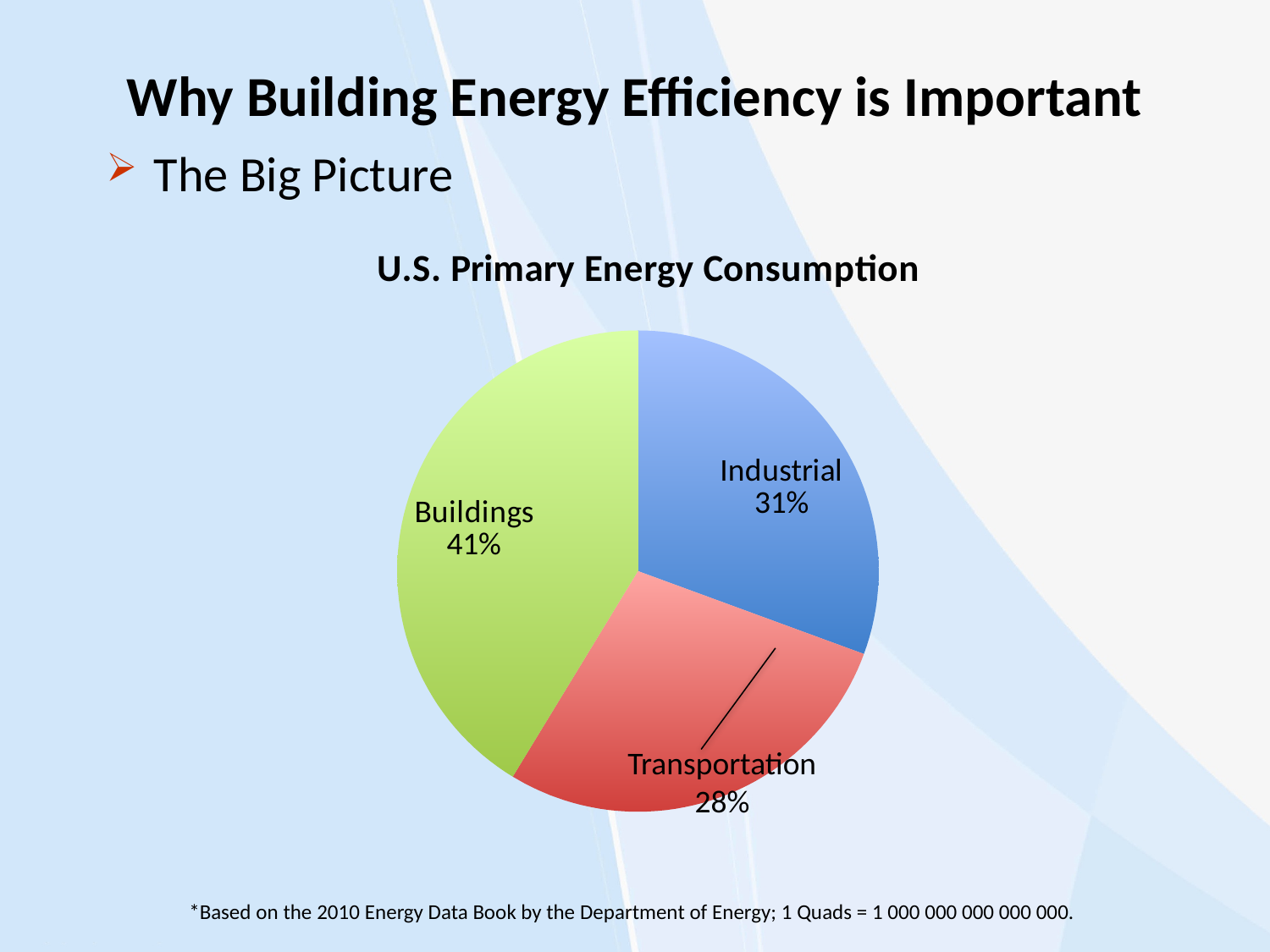
How many sectors are shown in the pie chart? 3 What is the title of the chart? U.S. Primary Energy Consumption What share of U.S. primary energy consumption is attributed to Transportation? 28% How many percentage points larger is the Industrial share than the Transportation share? 3% How many percentage points larger is the Buildings share than the Industrial share? 10% Which has a larger share of U.S. primary energy consumption, Buildings or Transportation? Buildings What kind of chart is shown on the slide? Pie chart What share of U.S. primary energy consumption is attributed to Buildings? 41% Which sector has the smallest share of U.S. primary energy consumption? Transportation What share of U.S. primary energy consumption is attributed to Industrial? 31% Which sector has the largest share of U.S. primary energy consumption? Buildings What colour is the Buildings slice of the pie chart? Green